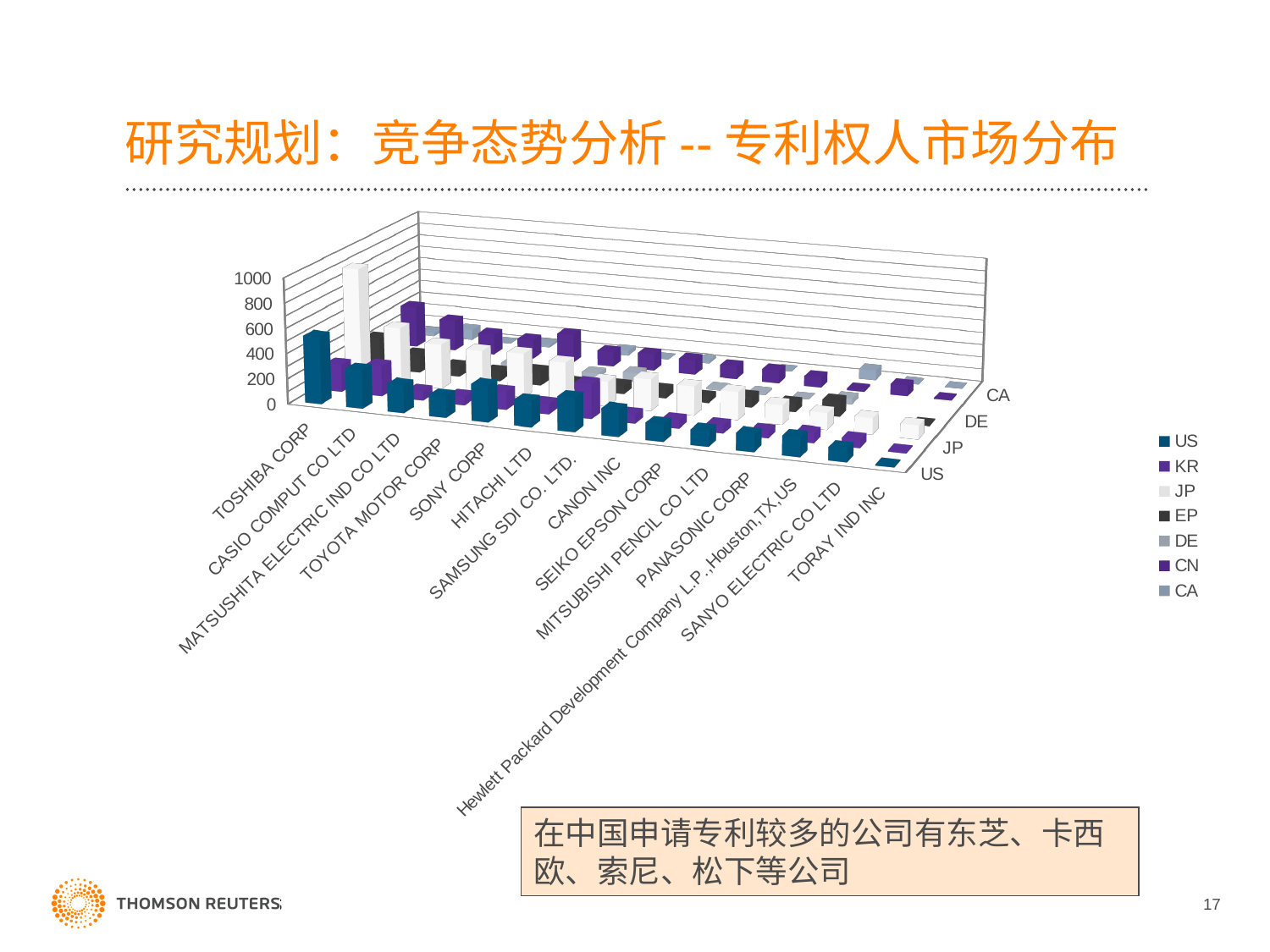
What is the highest value shown on the vertical axis of the chart? 1000 Which company is listed last on the category axis of the chart? TORAY IND INC What kind of chart is shown on the slide? bar chart Which series is listed first in the chart legend? US How many companies are listed along the category axis of the chart? 14 Is the US value for TOSHIBA CORP greater or less than 400? greater Is the US value for TORAY IND INC greater or less than 200? less Which is larger, the JP value for CASIO COMPUT CO LTD or the JP value for TORAY IND INC? CASIO COMPUT CO LTD How many series does the chart legend list? 7 Is the JP value for CASIO COMPUT CO LTD greater or less than 800? less Which company is listed first on the category axis of the chart? TOSHIBA CORP Which company has the tallest JP bar in the chart? TOSHIBA CORP